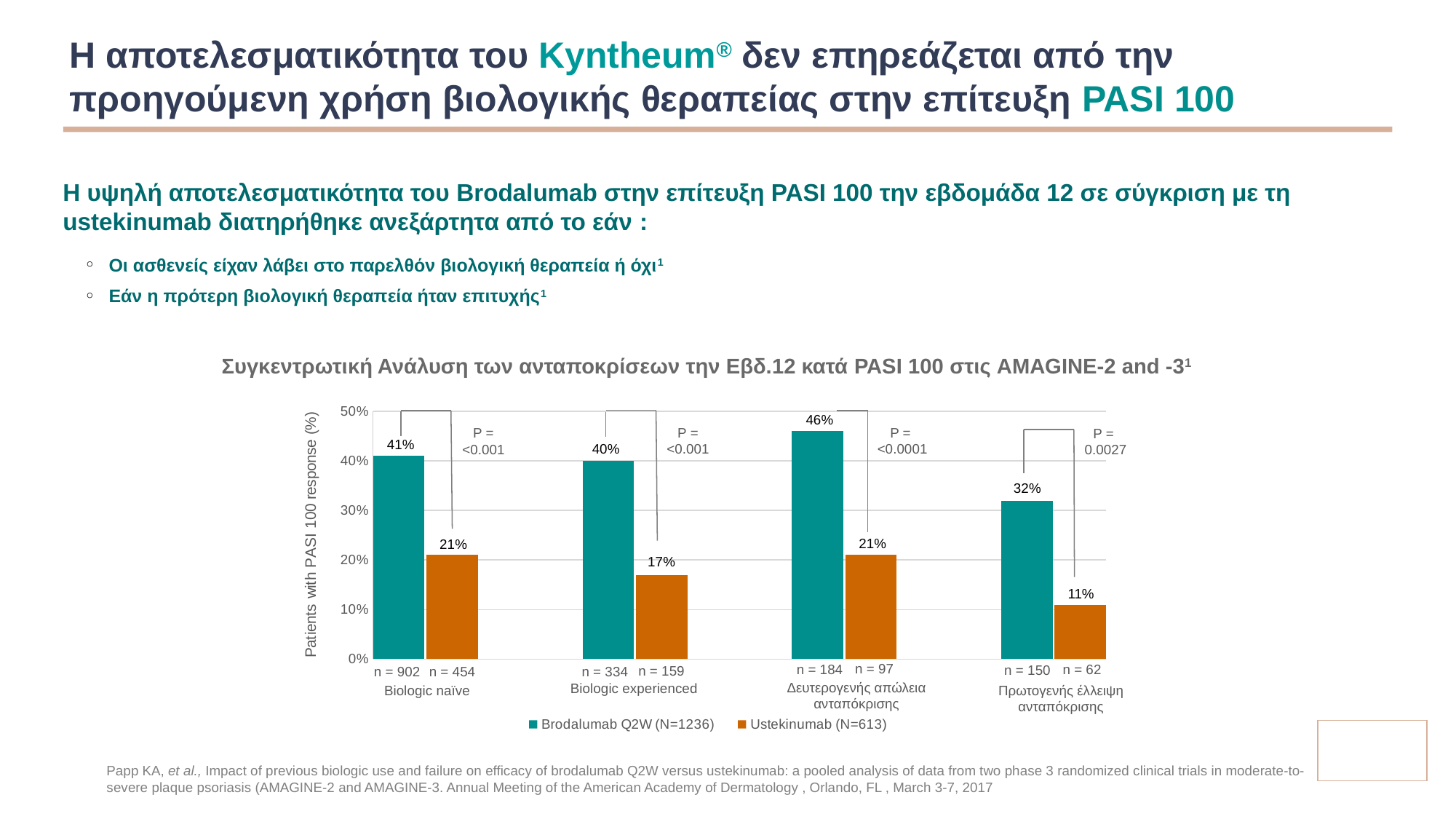
How many patient groups are shown on the x axis? 4 What kind of chart is shown on the slide? Bar chart In which group is the Ustekinumab value lowest? Πρωτογενής έλλειψη ανταπόκρισης What is the value for Ustekinumab in the Πρωτογενής έλλειψη ανταπόκρισης group? 11% What is the difference between the Brodalumab Q2W and Ustekinumab values in the Biologic naïve group? 20% What is the value for Brodalumab Q2W in the Biologic naïve group? 41% What is the label of the y axis? Patients with PASI 100 response (%) In which group is the Brodalumab Q2W value highest? Δευτερογενής απώλεια ανταπόκρισης Which is larger: the Brodalumab Q2W value in the Biologic experienced group or the Brodalumab Q2W value in the Πρωτογενής έλλειψη ανταπόκρισης group? Biologic experienced How many series does the legend list? 2 What is the difference between the Brodalumab Q2W and Ustekinumab values in the Δευτερογενής απώλεια ανταπόκρισης group? 25% What is the value for Ustekinumab in the Biologic experienced group? 17%